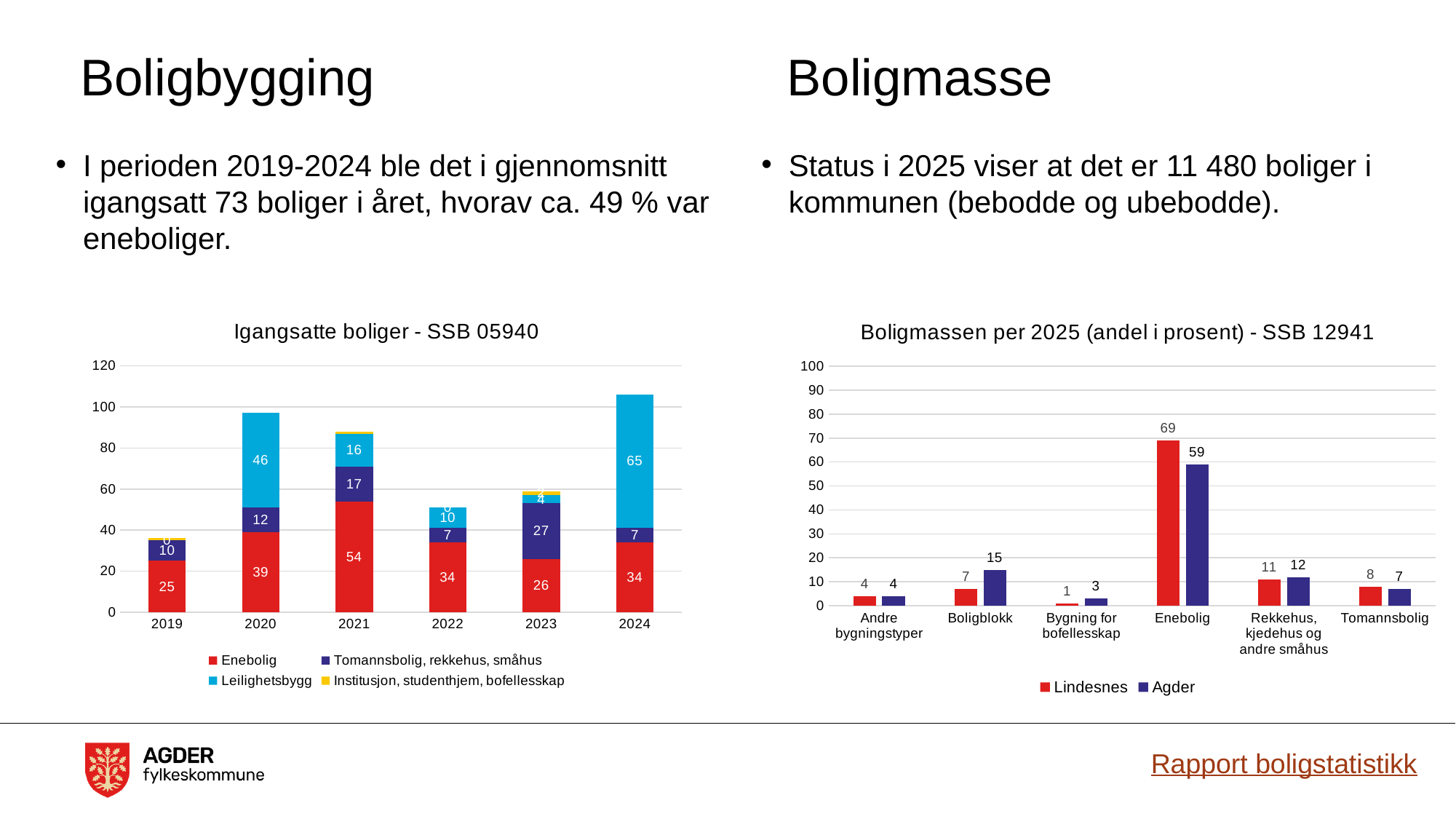
In the chart 'Igangsatte boliger - SSB 05940', how many series does the legend list? 4 In the chart 'Boligmassen per 2025 (andel i prosent) - SSB 12941', which is larger for Boligblokk, Lindesnes or Agder? Agder In the chart 'Boligmassen per 2025 (andel i prosent) - SSB 12941', how many categories are shown on the x axis? 6 In the chart 'Igangsatte boliger - SSB 05940', what is the difference between the Enebolig values for 2020 and 2023? 13 In the chart 'Boligmassen per 2025 (andel i prosent) - SSB 12941', which category has the lowest Lindesnes value? Bygning for bofellesskap In the chart 'Igangsatte boliger - SSB 05940', what is the value for Leilighetsbygg in 2024? 65 In the chart 'Boligmassen per 2025 (andel i prosent) - SSB 12941', what is the value for Agder for Boligblokk? 15 In the chart 'Igangsatte boliger - SSB 05940', what is the total of the stacked bar for 2020? 97 In the chart 'Igangsatte boliger - SSB 05940', what is the value for Enebolig in 2021? 54 In the chart 'Igangsatte boliger - SSB 05940', which year has the highest Enebolig value? 2021 In the chart 'Boligmassen per 2025 (andel i prosent) - SSB 12941', what is the value for Lindesnes for Enebolig? 69 What kind of chart is 'Boligmassen per 2025 (andel i prosent) - SSB 12941'? Bar chart